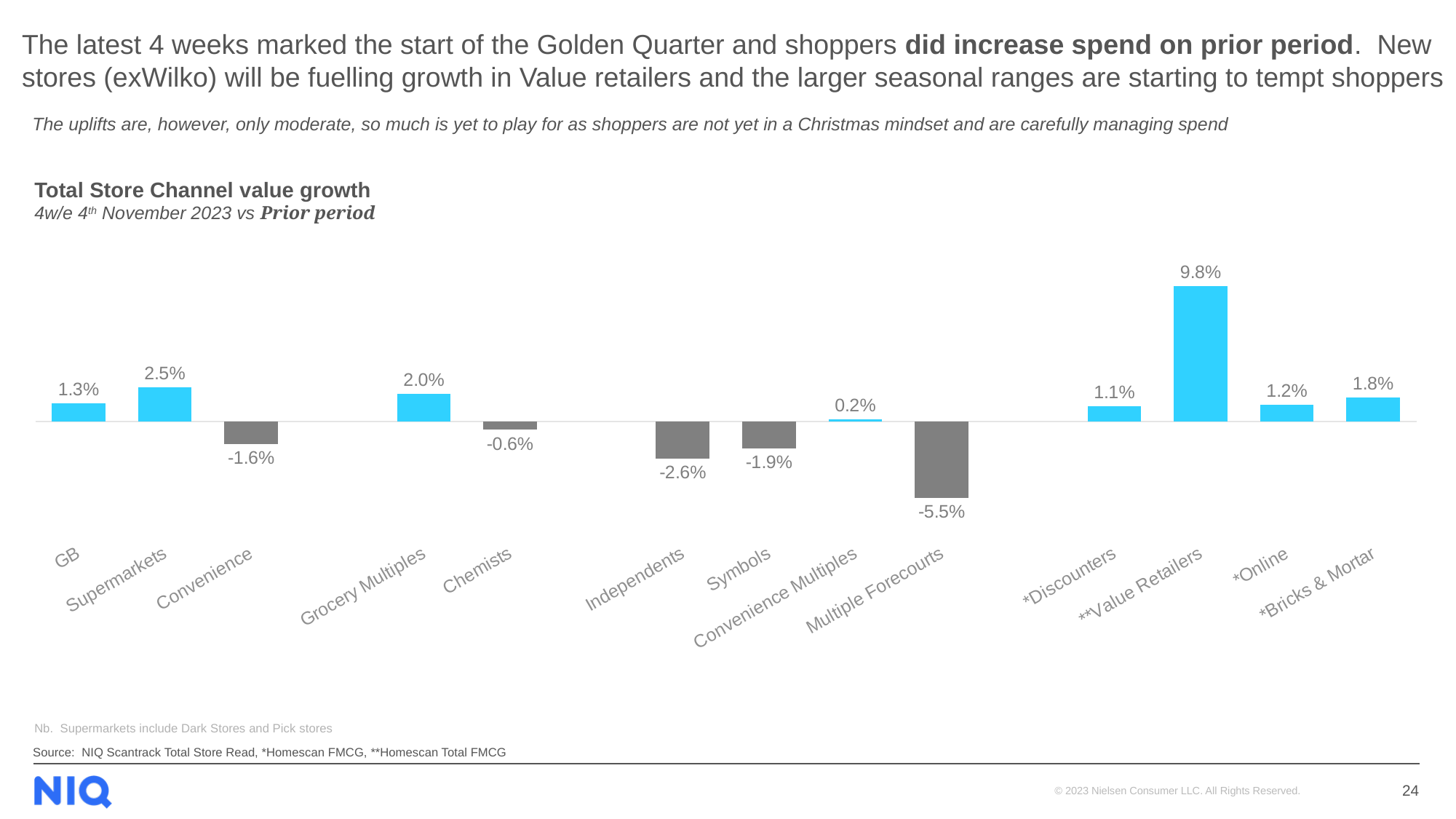
Which channel has the highest value growth? Value Retailers What is the value growth for Convenience Multiples? 0.2% What is the difference between the value growth for Supermarkets and Grocery Multiples? 0.5% What is the value growth for Multiple Forecourts? -5.5% What is the value growth for Supermarkets? 2.5% Which channel has the lowest value growth? Multiple Forecourts How many channels are shown in the chart? 13 Which has the larger value growth, Online or Bricks & Mortar? Bricks & Mortar What is the value growth for GB? 1.3% What is the value growth for Value Retailers? 9.8% What is the title of the chart? Total Store Channel value growth What type of chart is shown on the slide? Bar chart